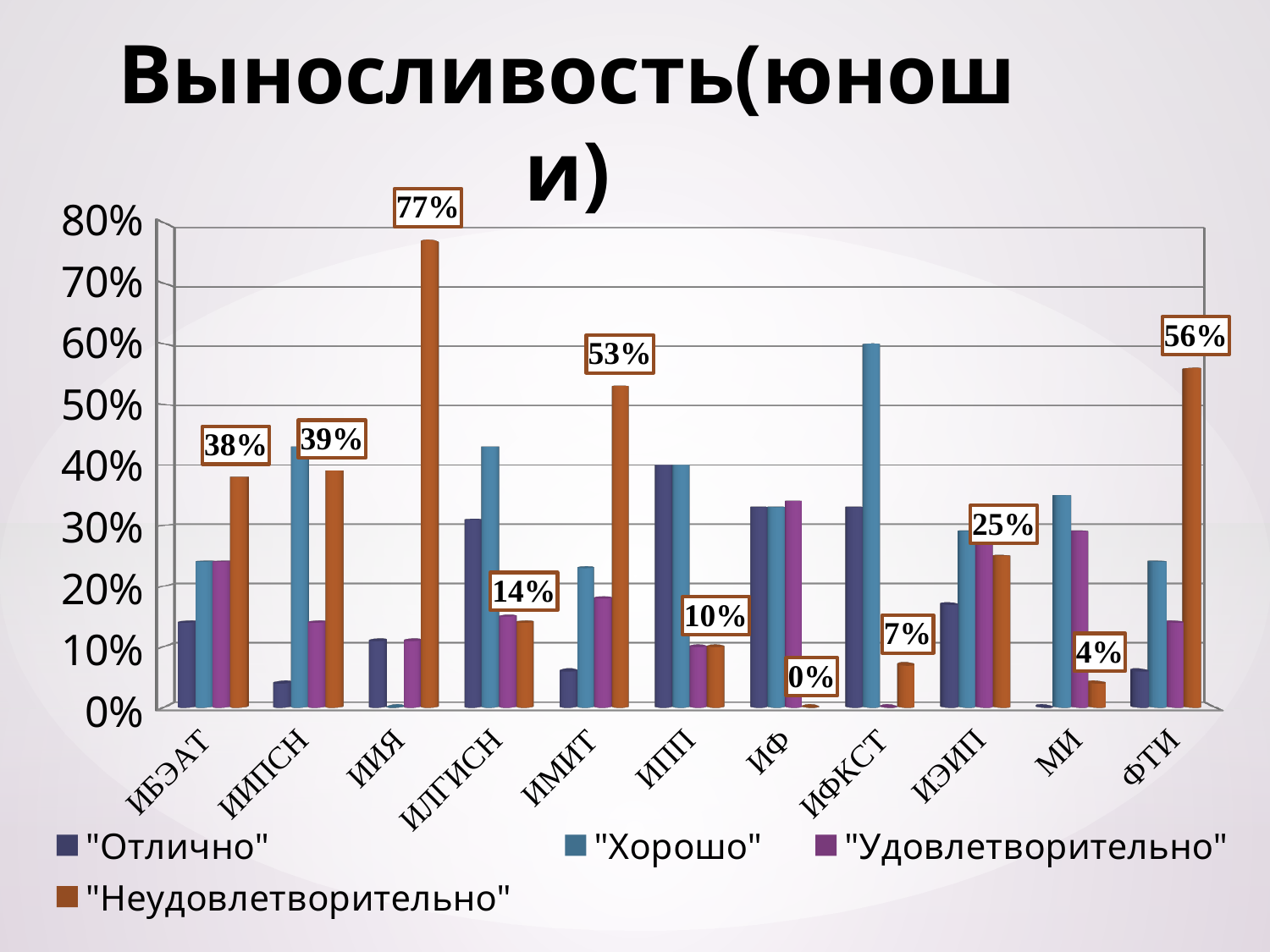
How many series does the legend list? 4 Is the "Отлично" value for ИПП greater or less than 30%? greater Which has the larger "Неудовлетворительно" value, ИЭИП or ИЛГИСН? ИЭИП What is the value of "Неудовлетворительно" for ИИЯ? 77% What kind of chart is shown on the slide? bar chart Which category has the highest "Неудовлетворительно" value? ИИЯ What is the value of "Неудовлетворительно" for ИМИТ? 53% How many categories are shown on the x axis? 11 Is the "Хорошо" value for ИФКСТ greater or less than 50%? greater What is the difference between the "Неудовлетворительно" values for ИИЯ and ФТИ? 21% What is the value of "Неудовлетворительно" for ФТИ? 56% Which category has the lowest "Неудовлетворительно" value? ИФ